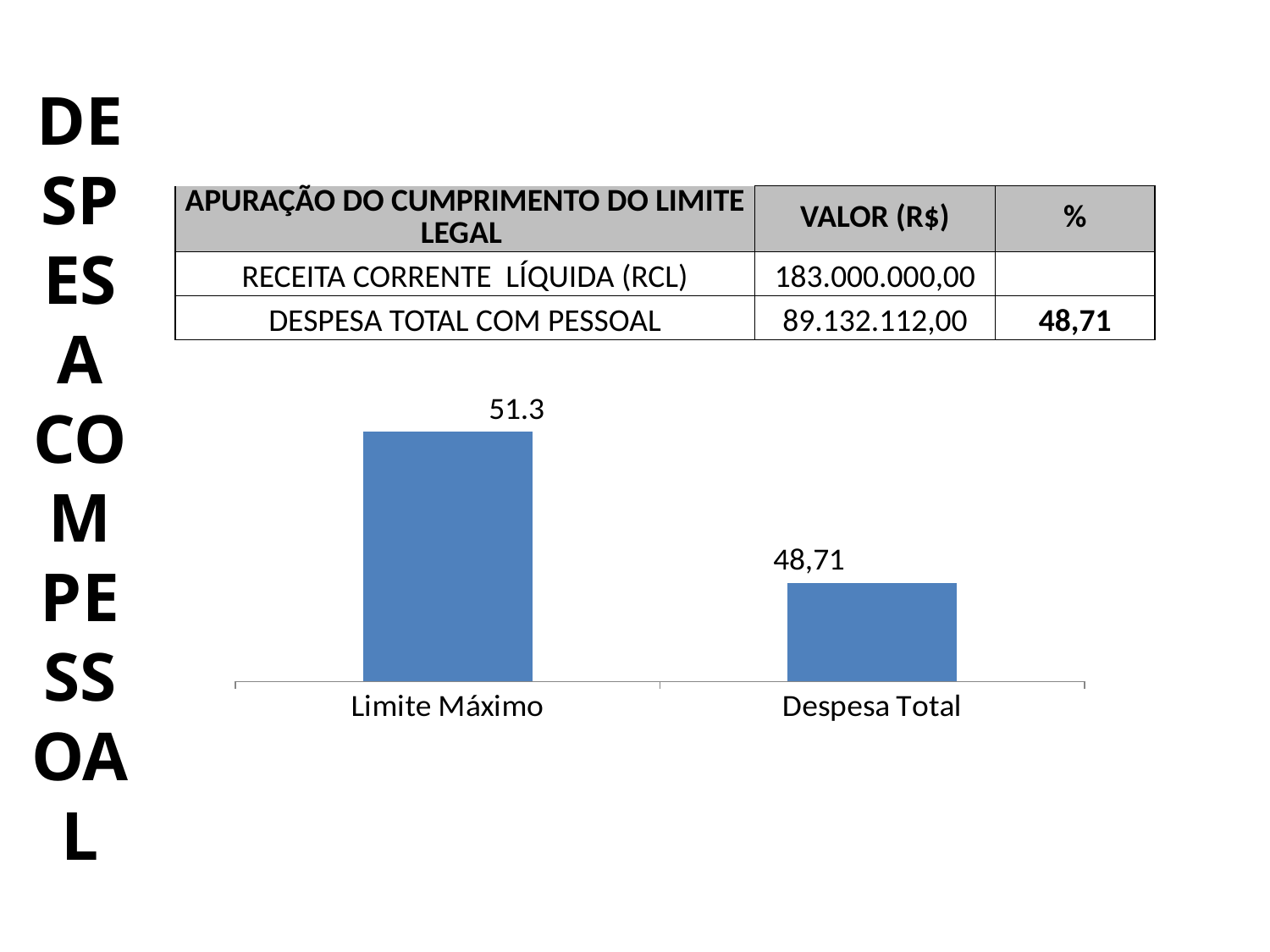
Which category has the highest bar? Limite Máximo What is the value shown for Despesa Total? 48,71 Do the values rise or fall from left to right along the x axis? Fall Which is larger, the value for Limite Máximo or the value for Despesa Total? Limite Máximo How many bars are plotted in the chart? 2 What colour are the bars in the chart? Blue What is the value shown for Limite Máximo? 51.3 What are the two category labels on the x axis of the chart? Limite Máximo and Despesa Total Which category has the lowest bar? Despesa Total What kind of chart is shown on the slide? Bar chart